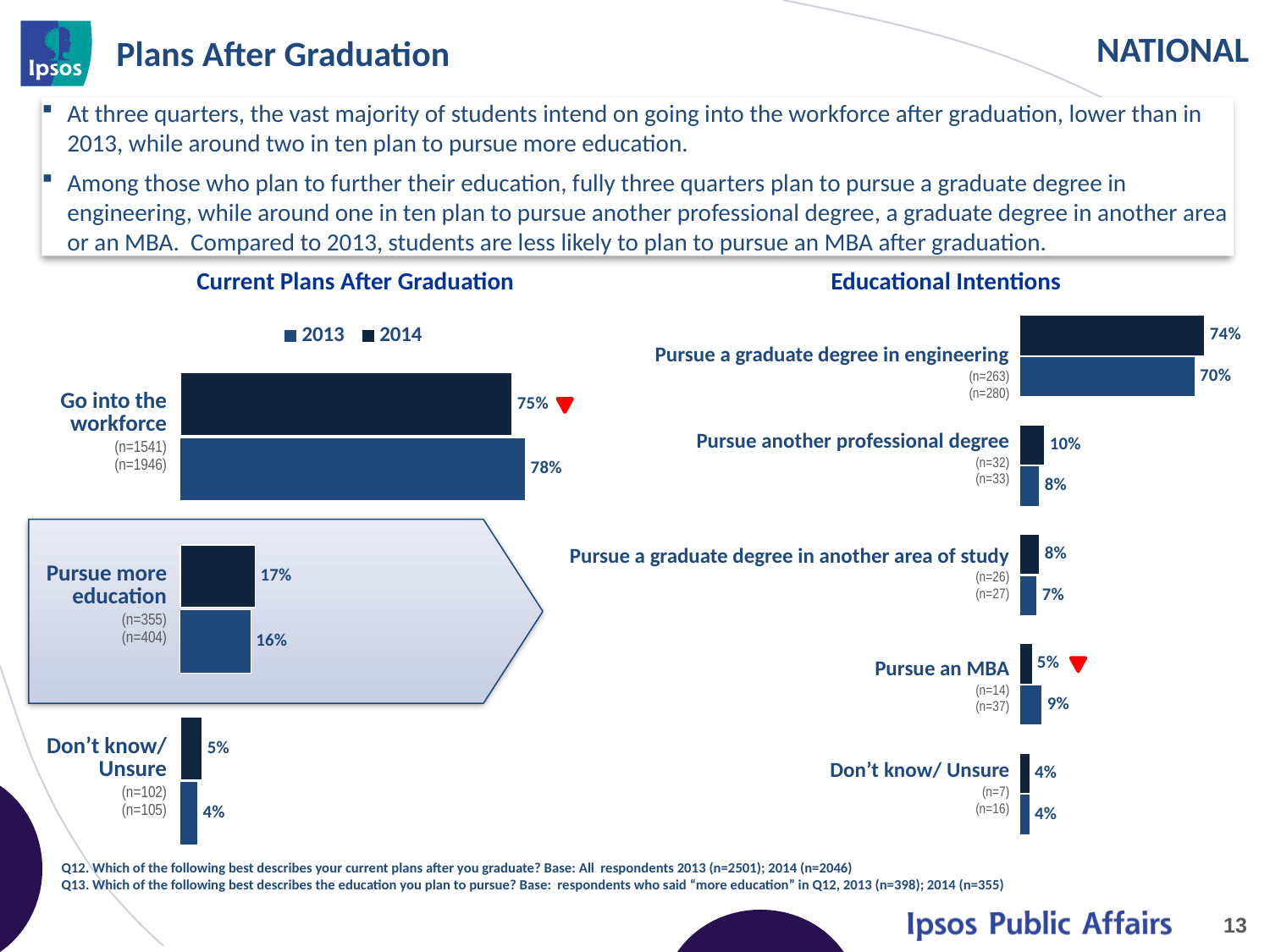
In the Educational Intentions chart, which category has the highest values? Pursue a graduate degree in engineering In the Educational Intentions chart, what are the two values shown for Pursue an MBA? 5% and 9% How many categories are shown in the Educational Intentions chart? 5 In the Current Plans After Graduation chart, what is the higher of the two values shown for Pursue more education? 17% In the Educational Intentions chart, which category has the lowest values? Don't know/ Unsure How many categories are shown in the Current Plans After Graduation chart? 3 In the Current Plans After Graduation chart, what are the two values shown for Go into the workforce? 75% and 78% In the Current Plans After Graduation chart, what is the difference between the two values shown for Go into the workforce? 3 percentage points In the Current Plans After Graduation chart, which category has the highest values? Go into the workforce What type of chart is used for Current Plans After Graduation? Bar chart How many series does the legend on the Current Plans After Graduation chart list? 2 Which two years are listed in the legend of the Current Plans After Graduation chart? 2013 and 2014